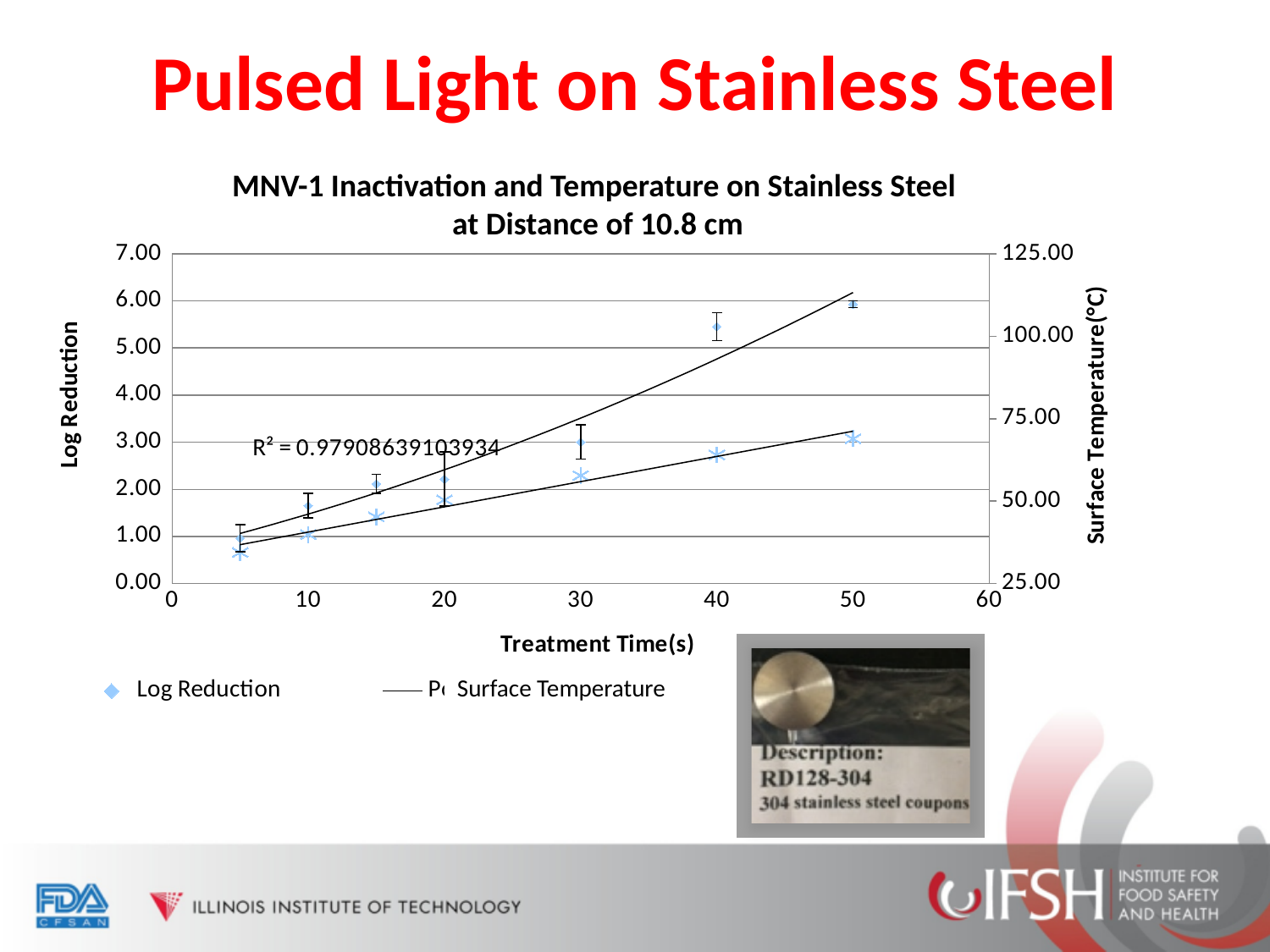
What kind of chart is shown on the slide? scatter chart How many Log Reduction data points are plotted on the chart? 7 Does the Surface Temperature rise or fall as Treatment Time increases? rise Does the Log Reduction rise or fall as Treatment Time increases? rise At which treatment time is the Log Reduction highest? 50 Is the Surface Temperature at a treatment time of 5 s greater or less than 50.00°C? less What is the title of the chart? MNV-1 Inactivation and Temperature on Stainless Steel at Distance of 10.8 cm Is the Log Reduction at a treatment time of 10 s greater or less than 2.00? less What R² value is printed on the chart? R² = 0.97908639103934 What is the label of the x axis? Treatment Time(s) Is the Surface Temperature at a treatment time of 50 s greater or less than 75.00°C? less